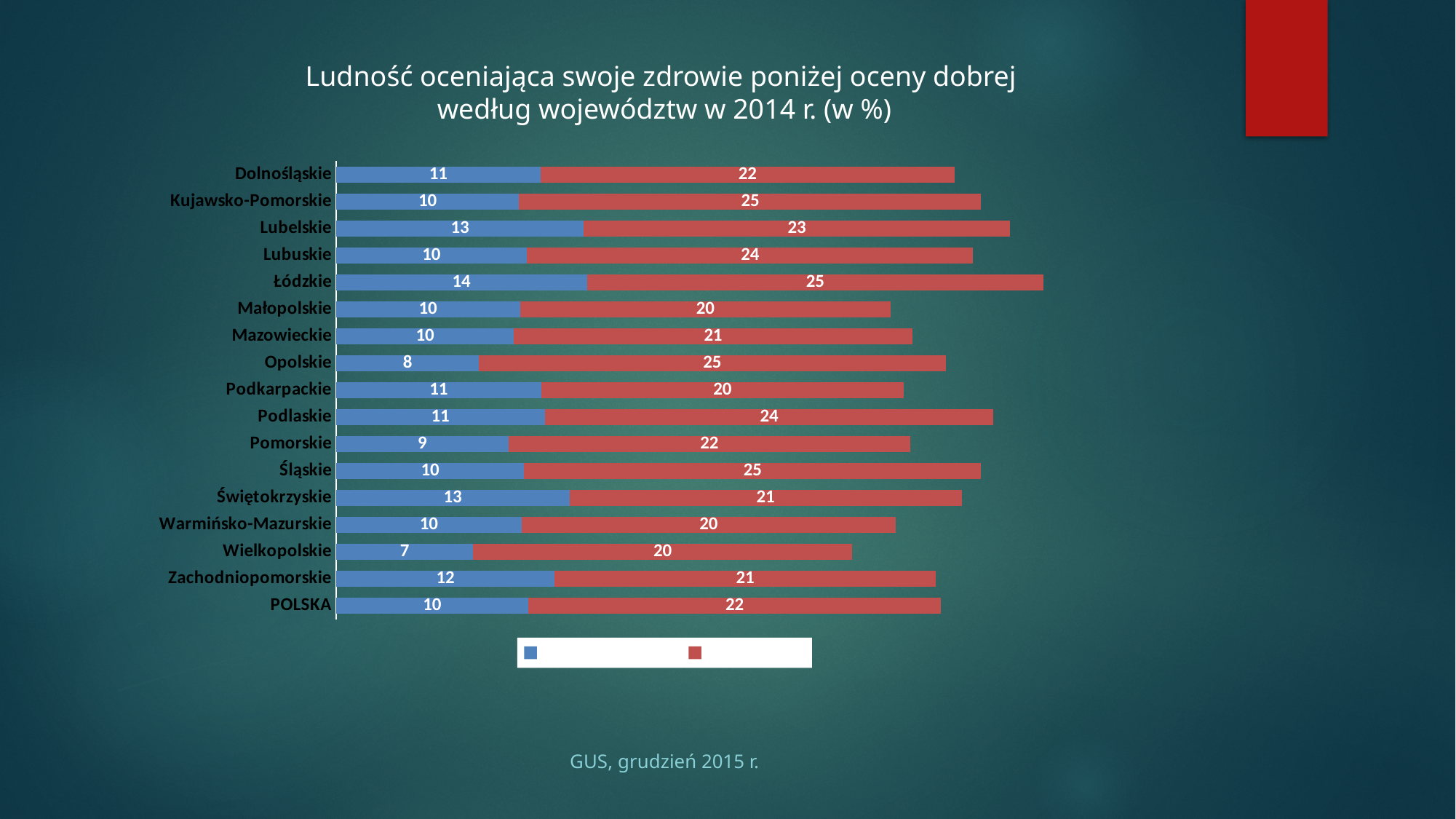
What is the value of the blue segment for Łódzkie? 14 Which category has the highest value in the blue series? Łódzkie What is the value of the red segment for Opolskie? 25 What is the value of the red segment for Wielkopolskie? 20 How many categories are shown on the chart? 17 Which is larger: the blue segment for Lubelskie or the blue segment for Pomorskie? Lubelskie What is the total of the stacked bar for Łódzkie? 39 What is the value of the blue segment for POLSKA? 10 What kind of chart is shown on the slide? Stacked bar chart What is the difference between the red segment values for Kujawsko-Pomorskie and Małopolskie? 5 What is the total of the stacked bar for Wielkopolskie? 27 Which category has the lowest value in the blue series? Wielkopolskie